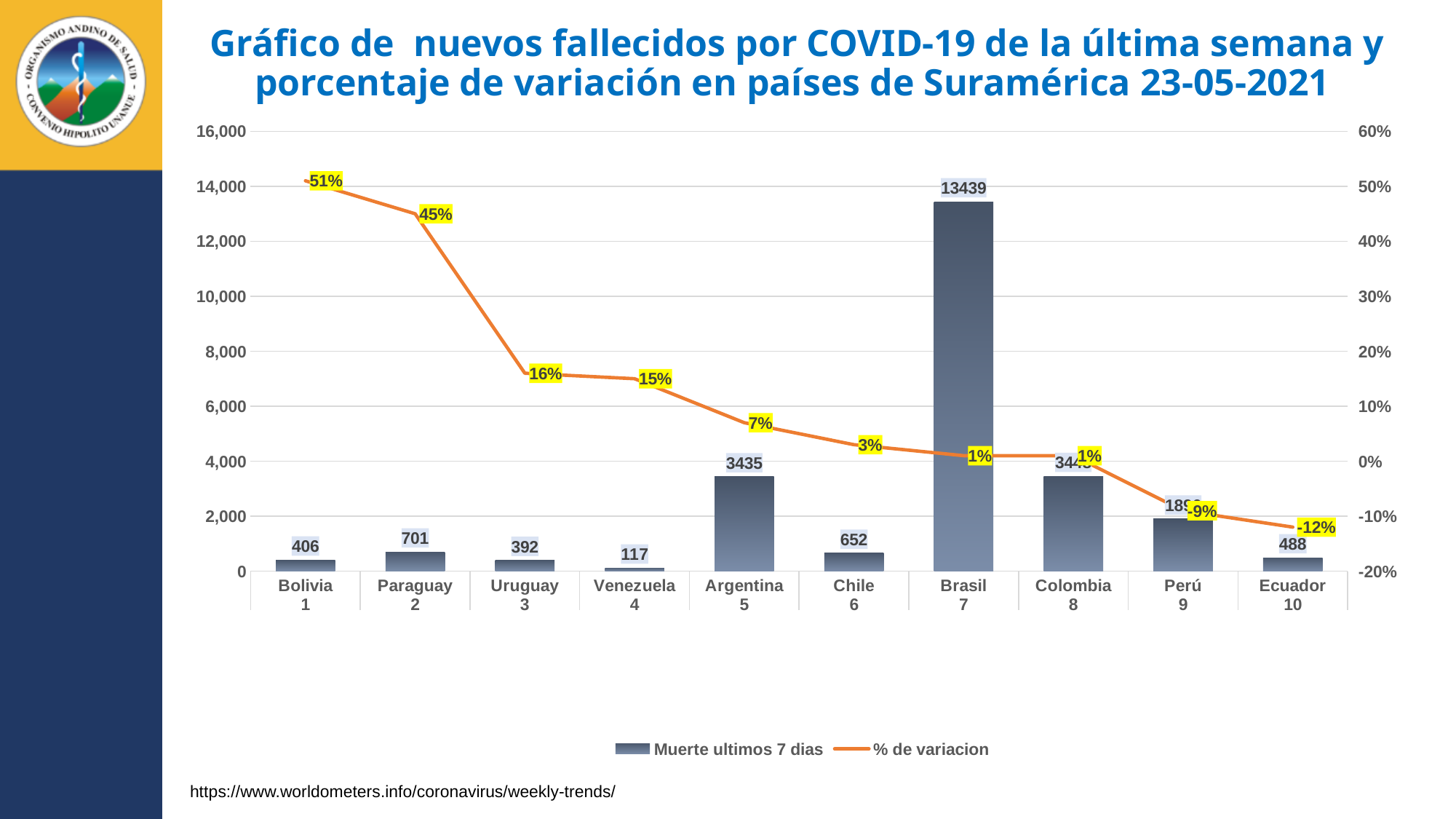
How many countries are shown on the x axis? 10 Which country has the lowest number of deaths in the last 7 days? Venezuela What is the difference in deaths in the last 7 days between Paraguay and Bolivia? 295 Is the '% de variacion' for Paraguay greater or less than 40%? greater What is the '% de variacion' for Bolivia? 51% Which has more deaths in the last 7 days, Chile or Uruguay? Chile How many series does the legend list? 2 Which country has the highest number of deaths in the last 7 days? Brasil Does the '% de variacion' line rise or fall from Bolivia to Ecuador? fall What is the '% de variacion' for Ecuador? -12% What is the value of 'Muerte ultimos 7 dias' for Brasil? 13439 What is the value of 'Muerte ultimos 7 dias' for Argentina? 3435